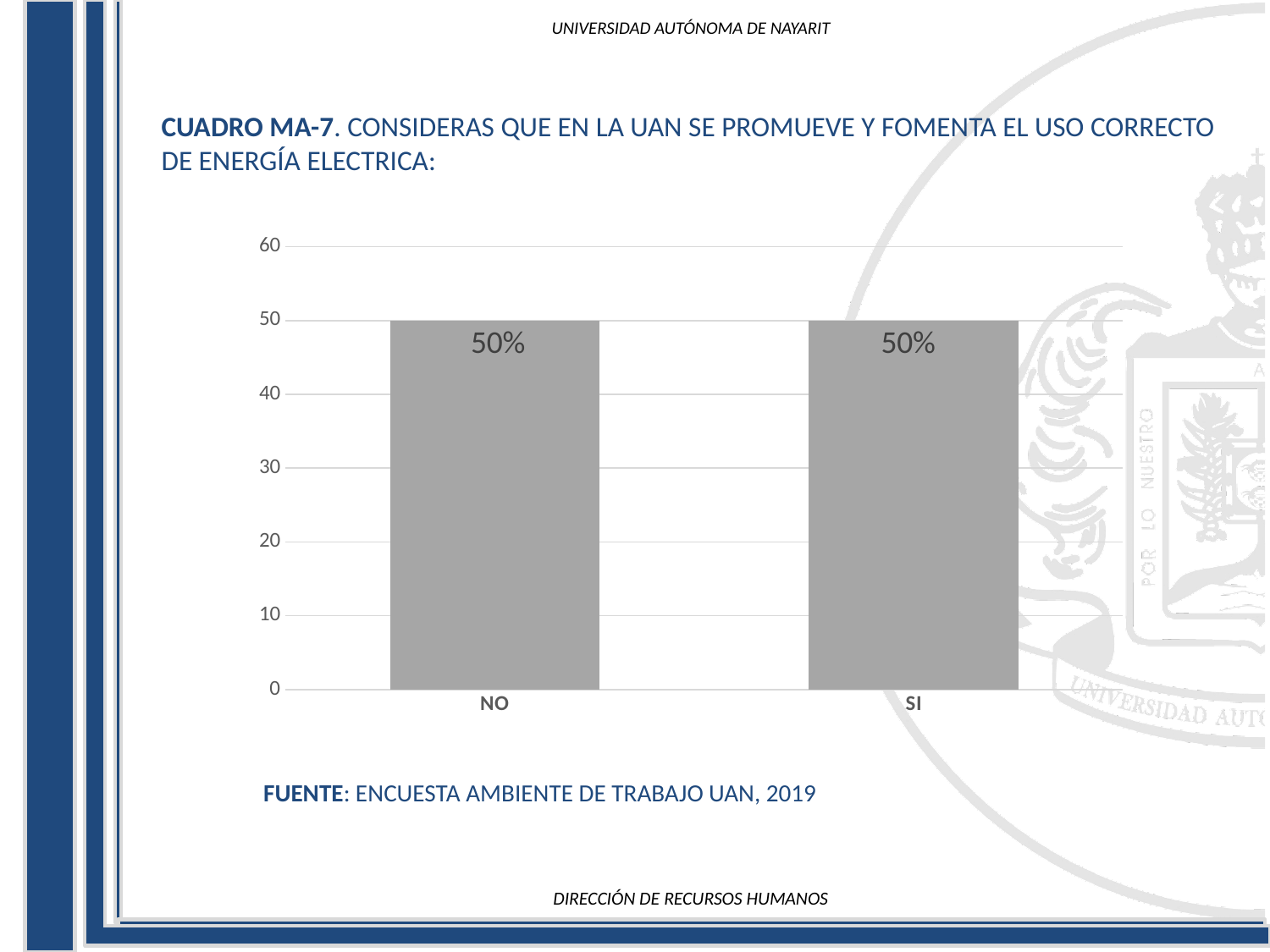
What kind of chart is shown on the slide? bar chart What is the value for SI? 50% Is the value for SI greater or less than 60? less Do the values rise, fall or stay the same from NO to SI? stay the same Is the value for NO greater or less than 40? greater What is the highest value shown on the y axis? 60 What source is cited below the chart? ENCUESTA AMBIENTE DE TRABAJO UAN, 2019 What is the value for NO? 50% How many categories are shown on the x axis? 2 What is the difference between the values for NO and SI? 0%